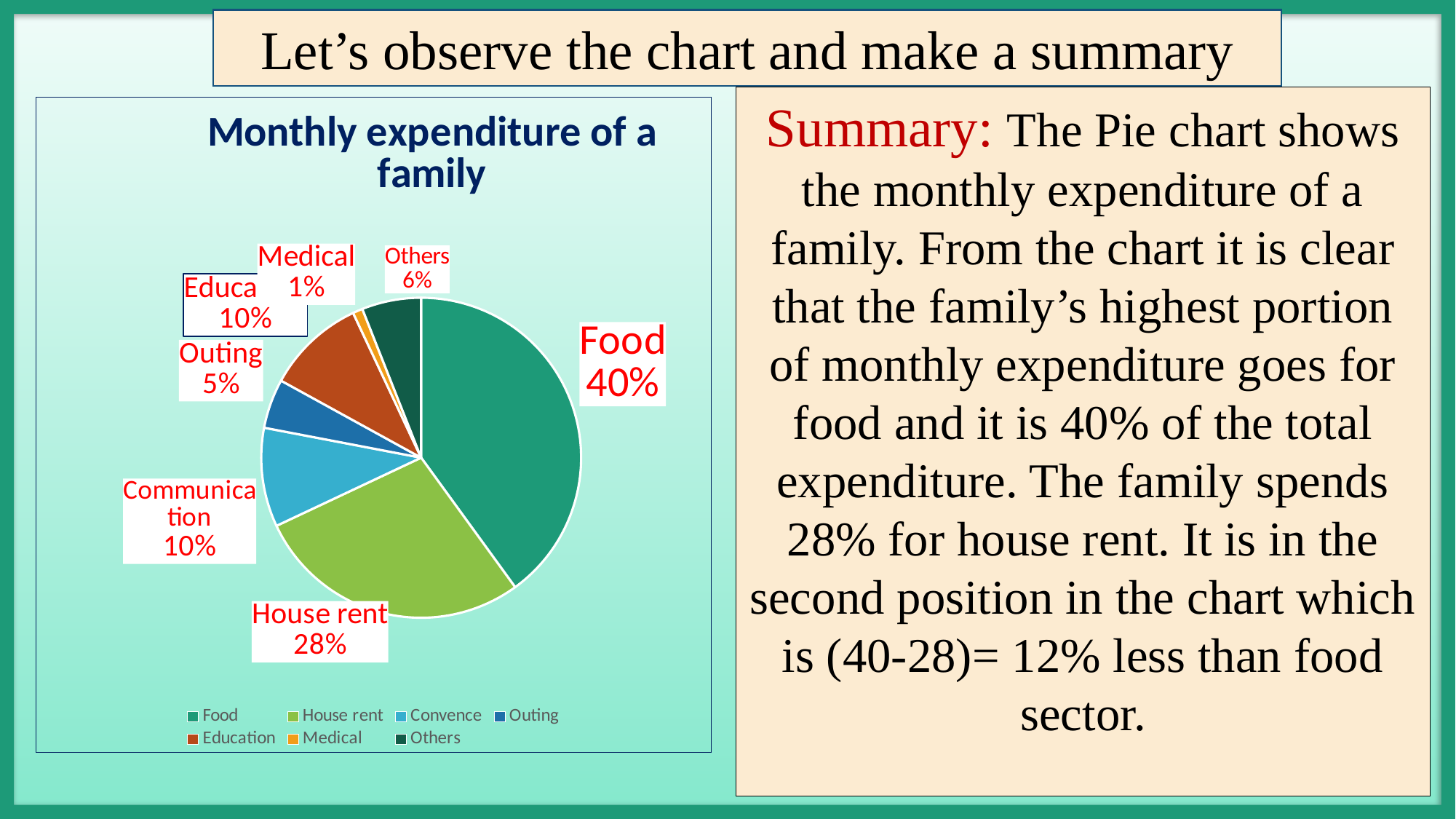
What percentage is shown for Outing? 5% What percentage is shown for Others? 6% Which category has the smallest share of the monthly expenditure? Medical What type of chart is shown on the slide? Pie chart What percentage of the monthly expenditure goes to Food? 40% Which category has the largest share of the monthly expenditure? Food What is the title of the chart? Monthly expenditure of a family What percentage is shown for Medical? 1% What percentage of the monthly expenditure goes to House rent? 28% How many categories does the pie chart show? 7 Which is larger, the share for Outing or the share for Others? Others How many percentage points larger is the Food share than the House rent share? 12%